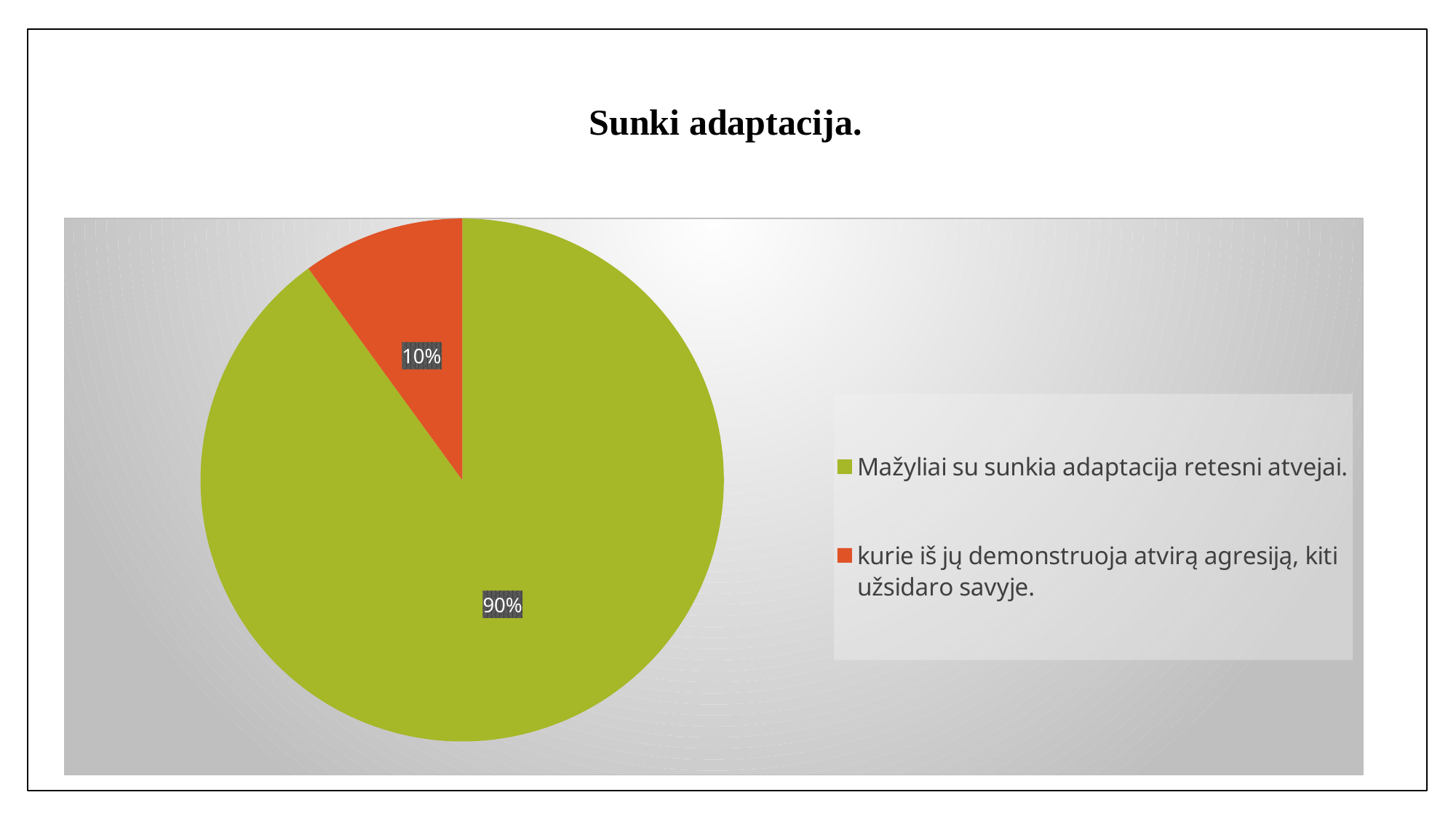
Which slice is the largest? Mažyliai su sunkia adaptacija retesni atvejai. What colour is the slice for "kurie iš jų demonstruoja atvirą agresiją, kiti užsidaro savyje."? orange Which is larger: the green slice or the orange slice? the green slice What kind of chart is shown on the slide? pie chart How many entries does the legend list? 2 What is the title of the slide? Sunki adaptacija. What is the difference between the two slices' values? 80% What is the value for "Mažyliai su sunkia adaptacija retesni atvejai."? 90% What is the value for "kurie iš jų demonstruoja atvirą agresiją, kiti užsidaro savyje."? 10% What share of the pie does the green slice represent? 90% How many slices does the pie chart have? 2 Which slice is the smallest? kurie iš jų demonstruoja atvirą agresiją, kiti užsidaro savyje.